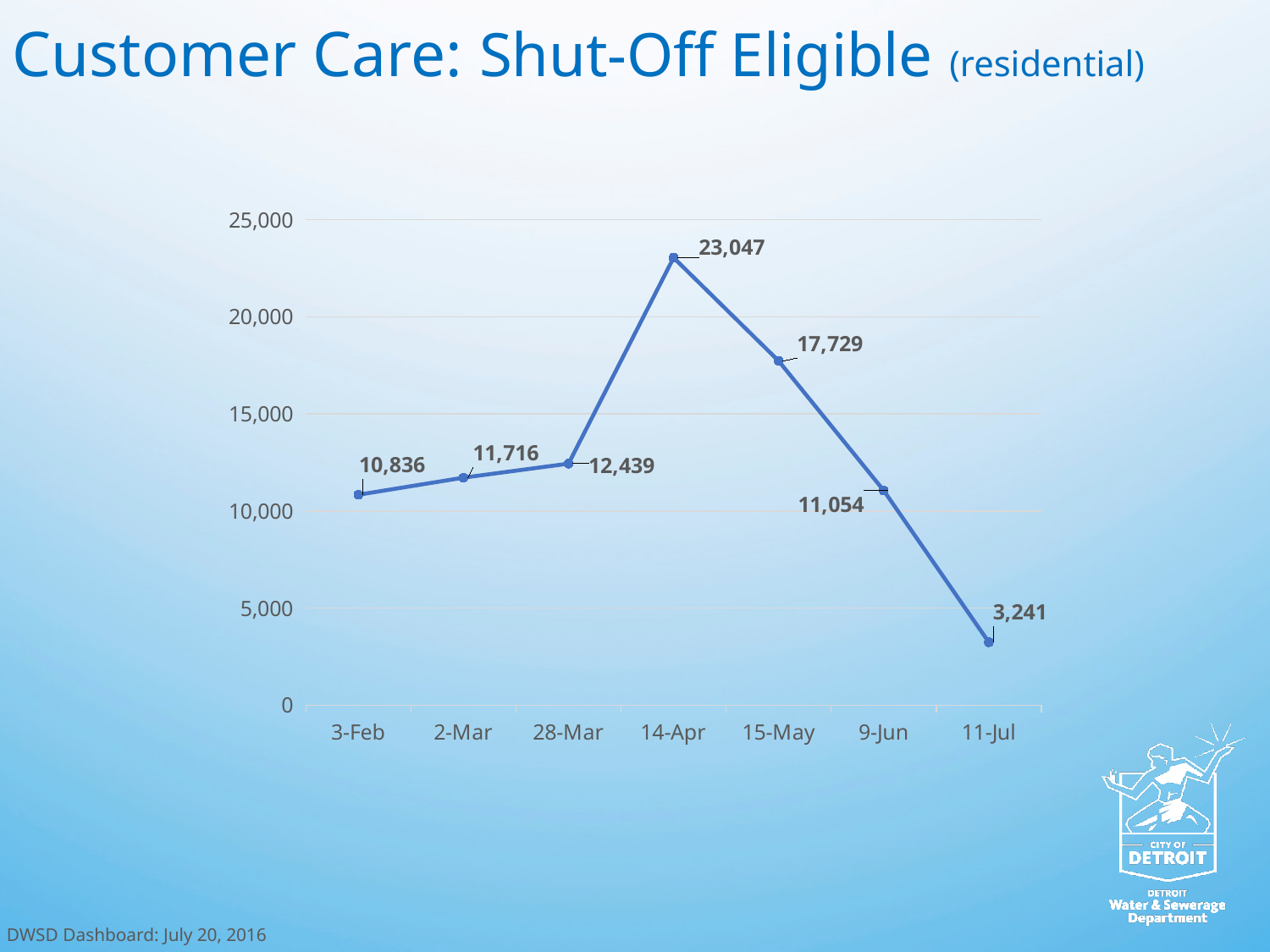
What is the value for 3-Feb? 10,836 What kind of chart is shown on the slide? Line chart What is the difference between the values for 14-Apr and 15-May? 5,318 Which is larger, the value for 28-Mar or the value for 9-Jun? 28-Mar Which date has the lowest value? 11-Jul What is the value for 11-Jul? 3,241 How many data points are plotted on the chart? 7 What is the difference between the values for 2-Mar and 3-Feb? 880 What is the value for 14-Apr? 23,047 Do the values rise or fall from 14-Apr to 11-Jul? Fall Which date has the highest value? 14-Apr What is the value for 9-Jun? 11,054